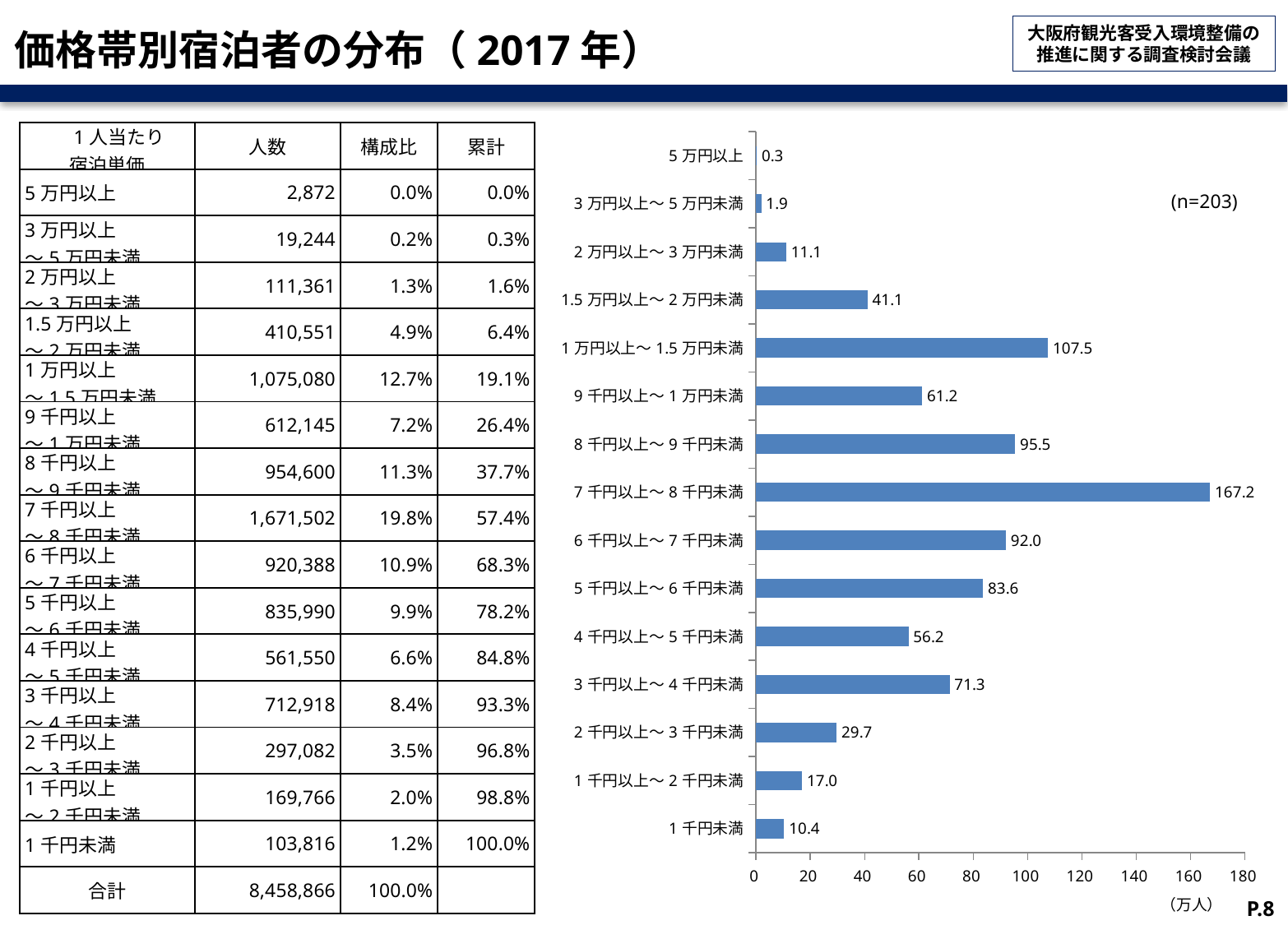
Which is larger in the bar chart: 3千円以上～4千円未満 or 9千円以上～1万円未満? 3千円以上～4千円未満 What kind of chart is shown on the slide? bar chart What sample size (n) is noted on the bar chart? n=203 What is the difference between the values for 8千円以上～9千円未満 and 6千円以上～7千円未満? 3.5 Which category has the highest value in the bar chart? 7千円以上～8千円未満 What unit is indicated below the x axis of the bar chart? 万人 What is the value for 1千円未満 in the bar chart? 10.4 How many categories are shown in the bar chart? 15 What is the value for 1万円以上～1.5万円未満 in the bar chart? 107.5 What is the value for 7千円以上～8千円未満 in the bar chart? 167.2 Is the value for 5千円以上～6千円未満 greater or less than 80? greater Which category has the lowest value in the bar chart? 5万円以上